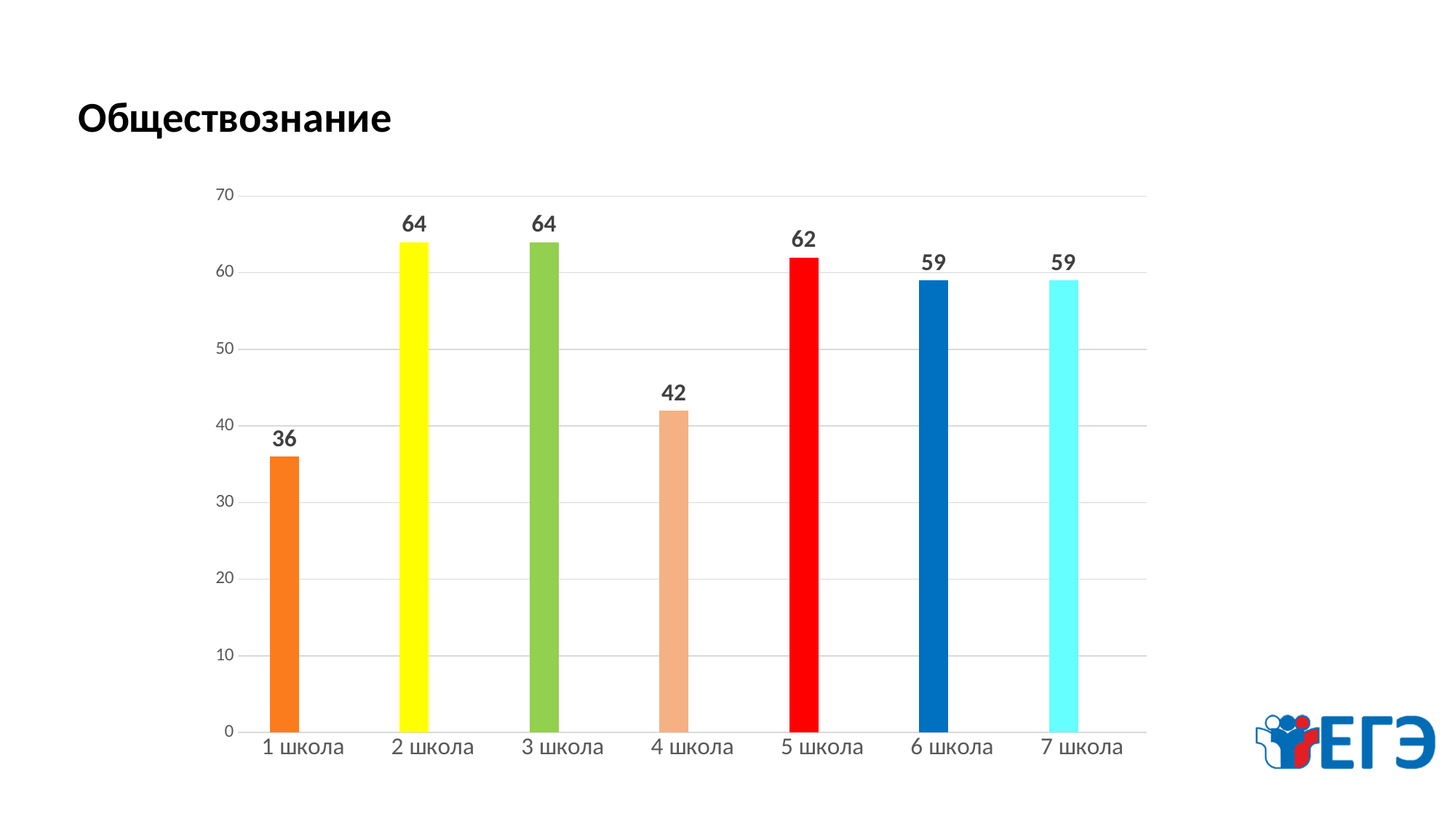
Which category has the lowest value? 1 школа Which is larger, the value for 4 школа or the value for 7 школа? 7 школа What kind of chart is shown on the slide? bar chart What is the difference between the values for 2 школа and 1 школа? 28 What is the value for 6 школа? 59 What is the difference between the values for 5 школа and 4 школа? 20 How many categories are shown on the x axis? 7 What is the value for 5 школа? 62 What is the value for 4 школа? 42 What is the value for 1 школа? 36 Is the value for 3 школа greater or less than 60? greater What is the title of the slide? Обществознание